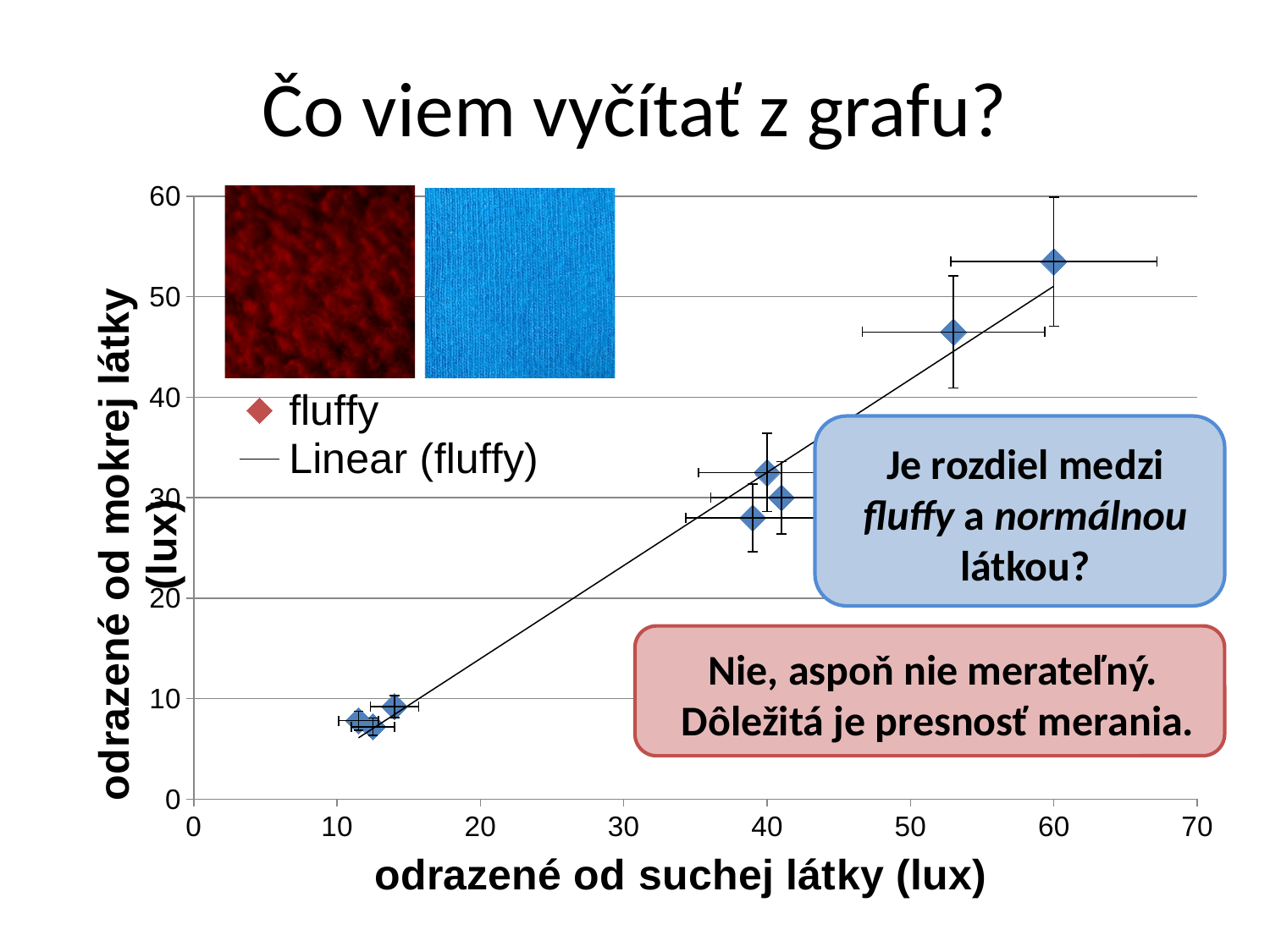
Do the plotted values rise or fall as the x-axis value (odrazené od suchej látky) increases? rise What are the two entries in the chart legend? fluffy and Linear (fluffy) Are the y values of the cluster of data points near 12 lux on the x axis greater or less than 10? less Are the y values of the cluster of data points near 40 lux on the x axis greater or less than 40? less Are the y values of the cluster of data points near 40 lux on the x axis greater or less than 20? greater How many entries does the chart legend list? 2 What is the maximum value shown on the x axis of the chart? 70 Which data point has the highest y value (odrazené od mokrej látky): the one at about 60 lux or the one at about 53 lux on the x axis? the one at about 60 lux What kind of chart is shown on the slide? scatter chart What is the label of the x axis of the chart? odrazené od suchej látky (lux)